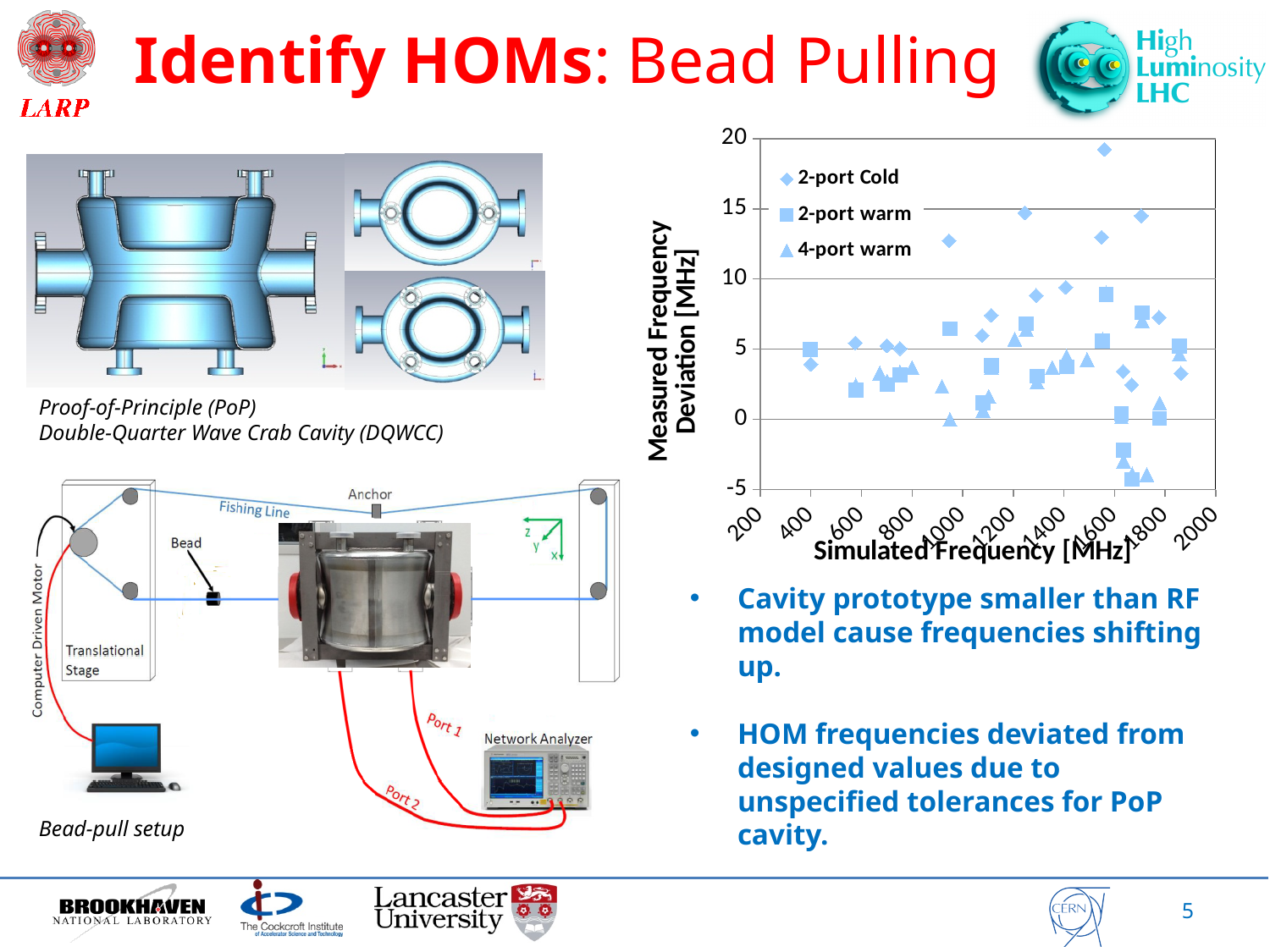
Which series contains the lowest measured frequency deviation on the chart? 2-port warm How many series does the chart legend list? 3 What kind of chart is shown on the slide? scatter chart Is the 2-port Cold point near 1000 MHz simulated frequency greater or less than 10 MHz deviation? greater Is the 2-port Cold point near 1400 MHz simulated frequency greater or less than 10 MHz deviation? less What are the three series listed in the chart legend? 2-port Cold, 2-port warm, 4-port warm Is the lowest 4-port warm point on the chart greater or less than 0? less Which series contains the highest measured frequency deviation on the chart? 2-port Cold What is the title of the chart's vertical axis? Measured Frequency Deviation [MHz]